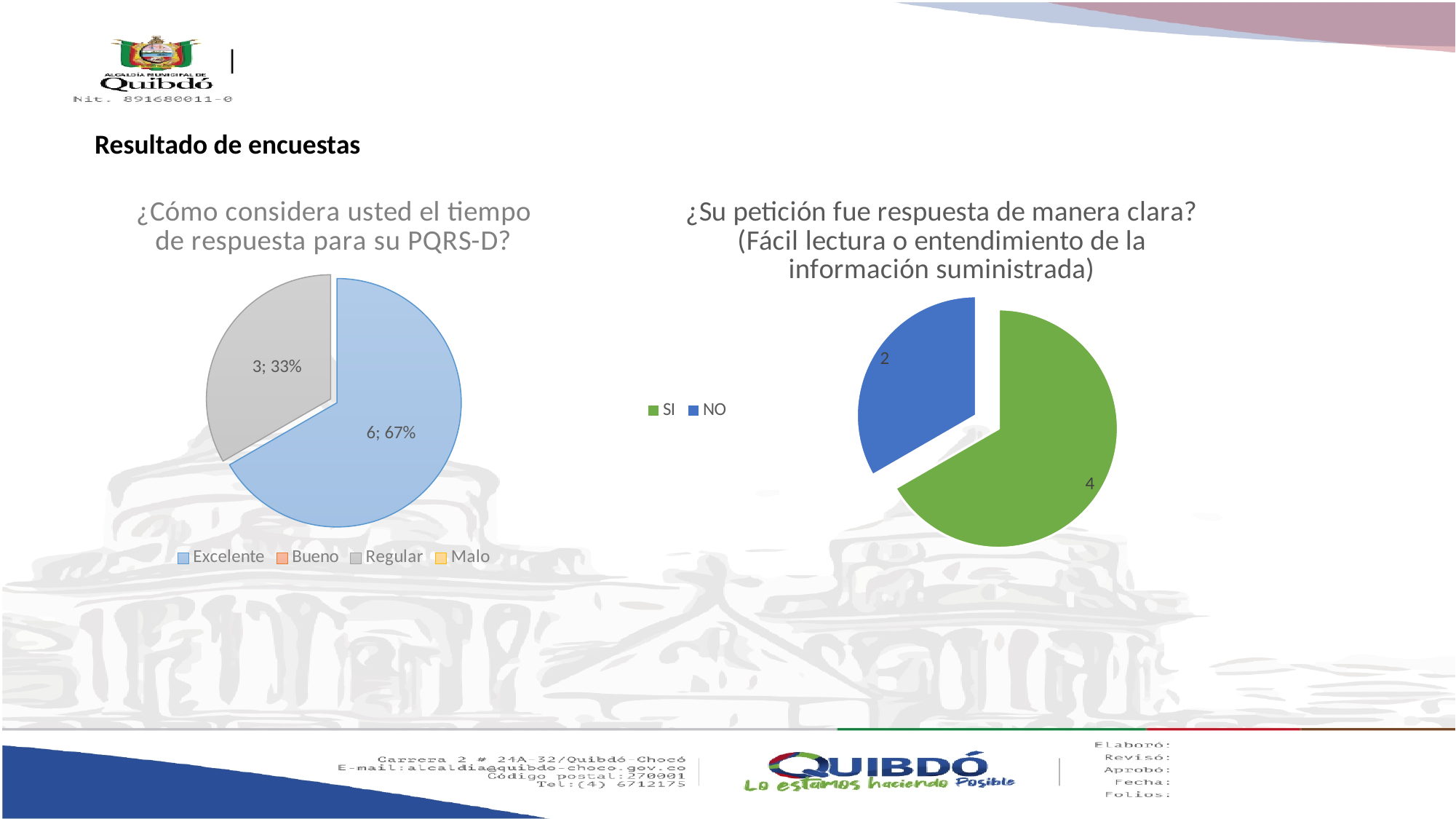
In the right pie chart about whether the petition was answered clearly, what colour is the SI slice? Green In the right pie chart about whether the petition was answered clearly, what value is shown for SI? 4 What kind of chart is the right chart about whether the petition was answered clearly? Pie chart In the left pie chart about the response time for the PQRS-D, what is the difference between the counts for Excelente and Regular? 3 In the right pie chart about whether the petition was answered clearly, what is the total of SI and NO? 6 In the right pie chart about whether the petition was answered clearly, which category is larger, SI or NO? SI How many entries does the legend of the left pie chart about the response time for the PQRS-D list? 4 In the left pie chart about the response time for the PQRS-D, which category has the largest slice? Excelente In the right pie chart about whether the petition was answered clearly, what value is shown for NO? 2 In the left pie chart about the response time for the PQRS-D, what value is shown for Excelente? 6; 67% In the left pie chart about the response time for the PQRS-D, what share of the pie does Regular represent? 33% In the left pie chart about the response time for the PQRS-D, what value is shown for Regular? 3; 33%